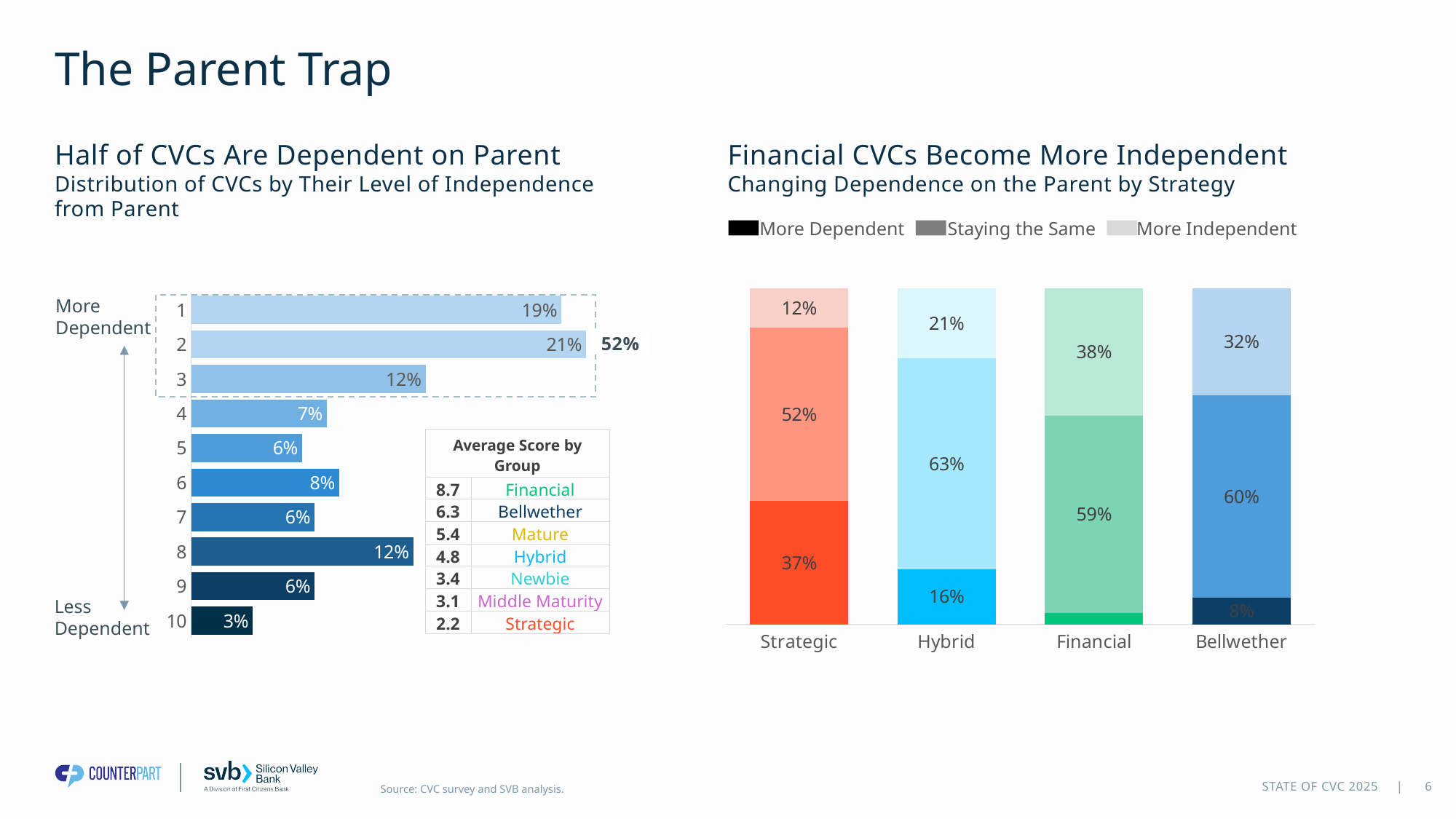
In the chart 'Financial CVCs Become More Independent', what percentage of Hybrid CVCs are More Independent? 21% How many levels are shown in the chart 'Half of CVCs Are Dependent on Parent'? 10 In the chart 'Half of CVCs Are Dependent on Parent', what is the difference between the percentage at level 1 and the percentage at level 10? 16 percentage points How many series does the legend list in the chart 'Financial CVCs Become More Independent'? 3 In the chart 'Half of CVCs Are Dependent on Parent', what combined percentage is shown for levels 1 to 3? 52% In the chart 'Financial CVCs Become More Independent', what percentage of Strategic CVCs are Staying the Same? 52% In the chart 'Financial CVCs Become More Independent', which strategy has the highest More Dependent percentage? Strategic In the chart 'Half of CVCs Are Dependent on Parent', which level has the lowest percentage of CVCs? 10 In the chart 'Financial CVCs Become More Independent', which has a larger More Independent percentage, Financial or Bellwether? Financial What kind of chart is 'Half of CVCs Are Dependent on Parent'? Bar chart In the chart 'Half of CVCs Are Dependent on Parent', which level has the highest percentage of CVCs? 2 In the chart 'Half of CVCs Are Dependent on Parent', what percentage of CVCs are at level 2? 21%